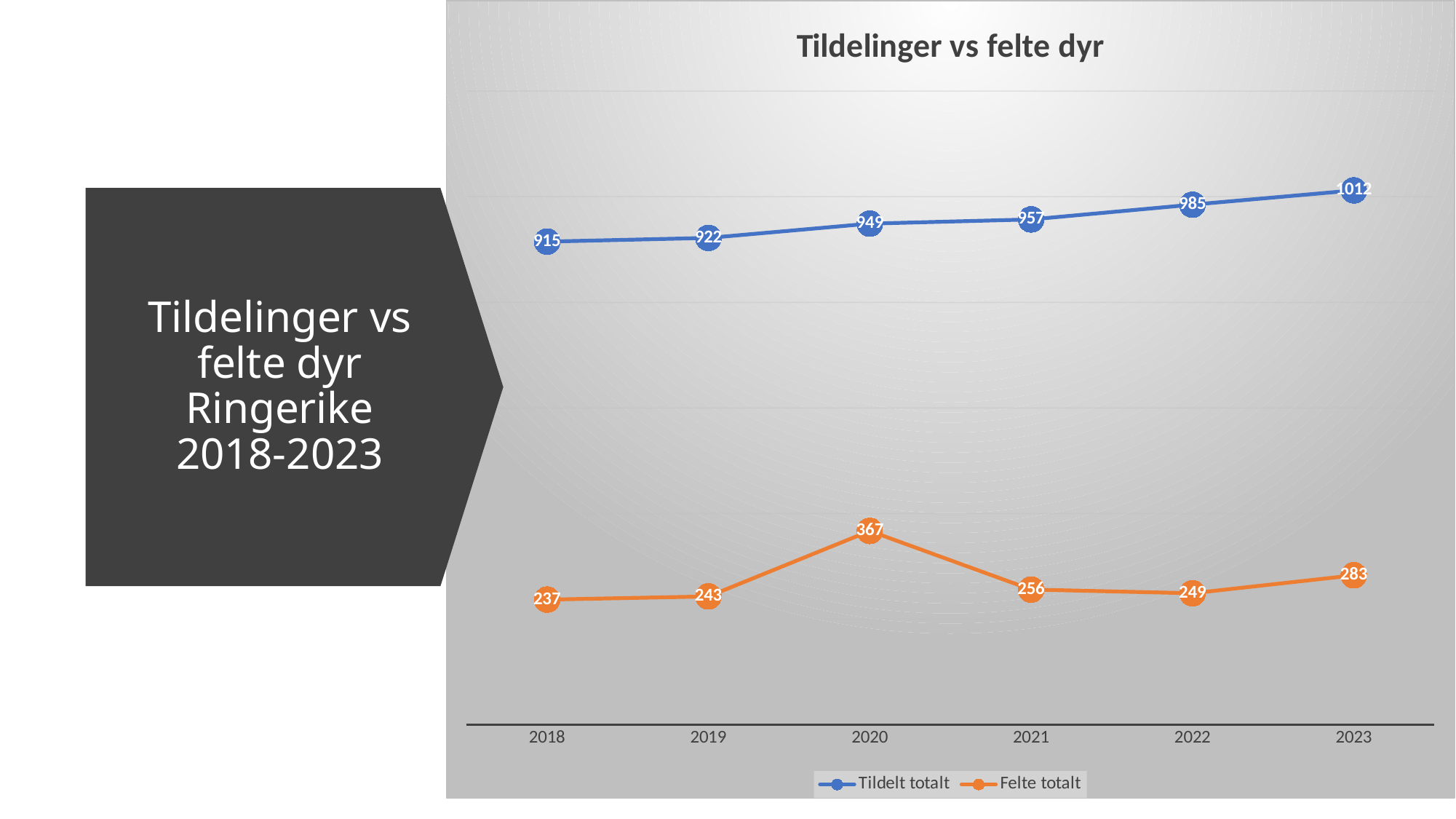
By how much did Felte totalt change from 2019 to 2020? 124 What is the title of the chart? Tildelinger vs felte dyr In which year is Tildelt totalt lowest? 2018 What kind of chart is shown? line chart What is the value of Tildelt totalt in 2020? 949 What is the difference between Tildelt totalt and Felte totalt in 2023? 729 How many years are shown on the x axis? 6 What is the value of Felte totalt in 2022? 249 Does Tildelt totalt rise or fall from 2018 to 2023? rise Which is larger, Felte totalt in 2018 or Felte totalt in 2021? 2021 How many series does the legend list? 2 In which year is Felte totalt highest? 2020